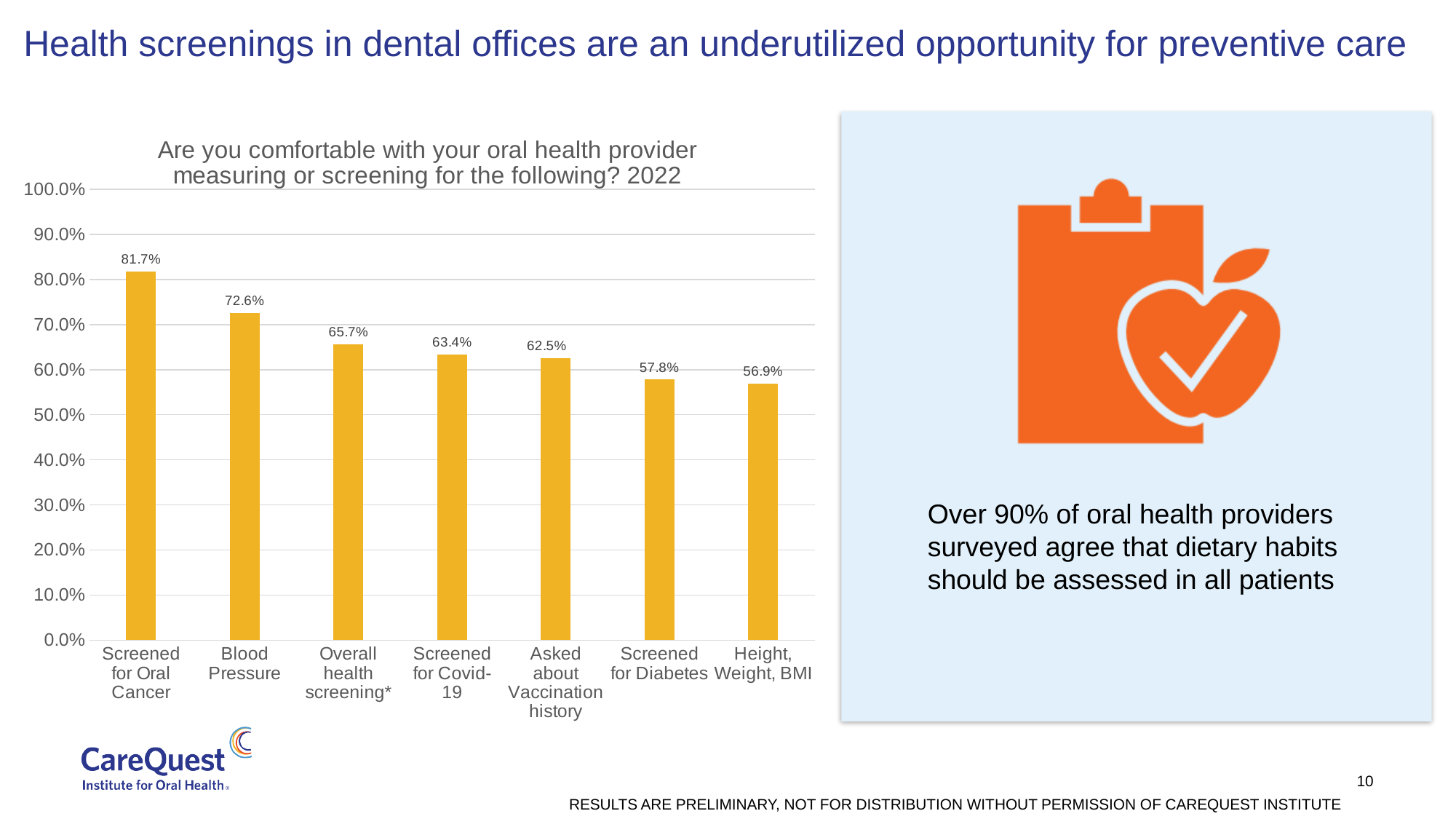
Is the value for Screened for Covid-19 greater or less than 60.0%? greater What kind of chart is shown on the slide? Bar chart What is the value for Blood Pressure? 72.6% Do the values rise or fall from left to right along the x axis? Fall What is the value for Height, Weight, BMI? 56.9% How many categories are shown in the bar chart? 7 What percentage of respondents are comfortable with their oral health provider screening for oral cancer? 81.7% Which category has the highest value? Screened for Oral Cancer What is the value for Asked about Vaccination history? 62.5% Which category has the lowest value? Height, Weight, BMI Which is larger, the value for Overall health screening* or the value for Screened for Diabetes? Overall health screening* What is the difference between the values for Screened for Oral Cancer and Blood Pressure? 9.1%